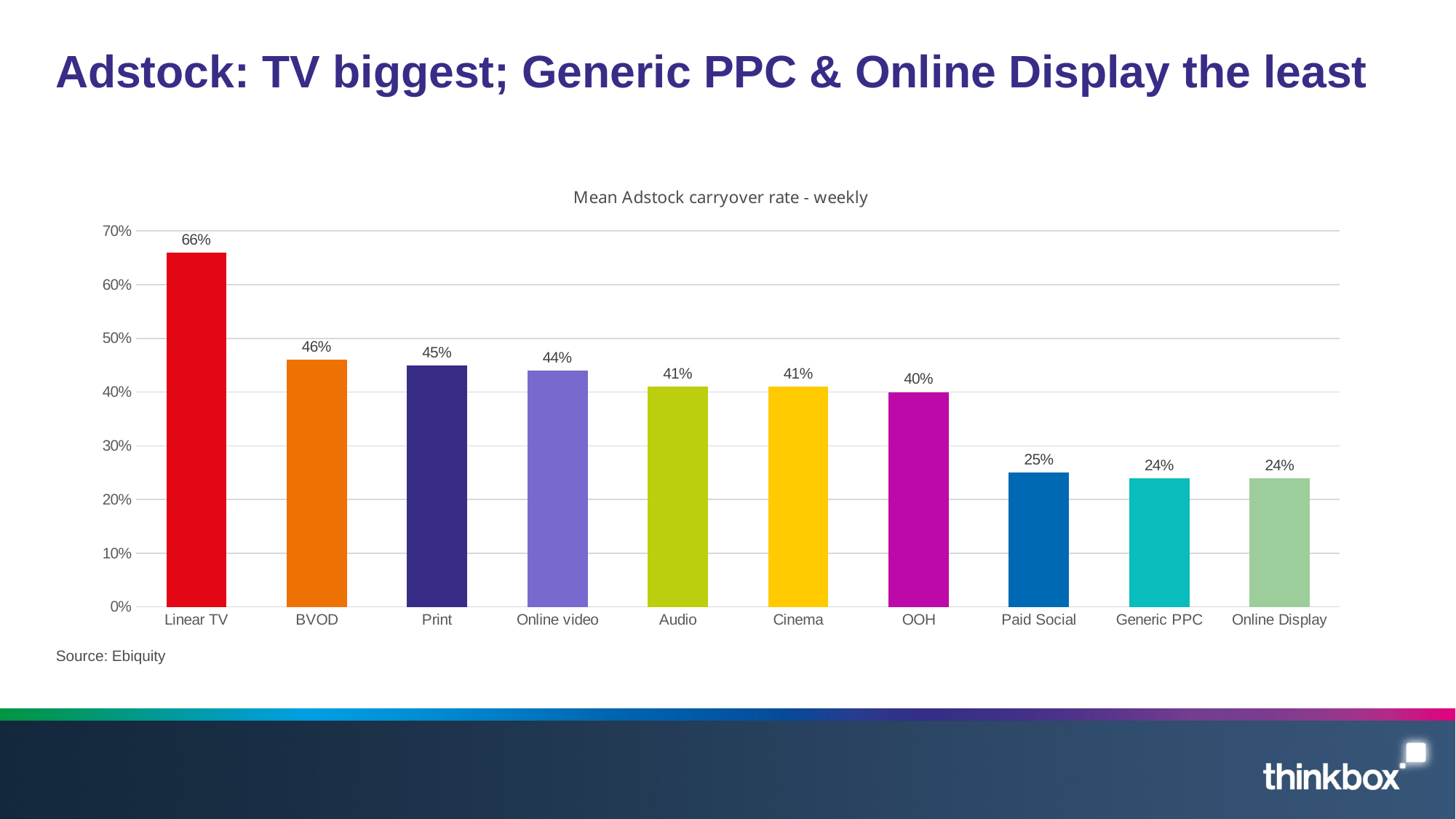
What is the difference between the values for Linear TV and BVOD? 20% What is the title of the chart? Mean Adstock carryover rate - weekly What kind of chart is shown on the slide? bar chart Is the value for Audio greater or less than 50%? less What is the value shown for Online video? 44% What is the mean Adstock carryover rate for Linear TV? 66% Do the values generally rise or fall from left to right along the x axis? fall What is the value shown for Paid Social? 25% How many categories are shown on the x axis? 10 Which category has the highest mean Adstock carryover rate? Linear TV Which is larger, the value for Print or the value for Paid Social? Print What is the difference between the values for OOH and Paid Social? 15%